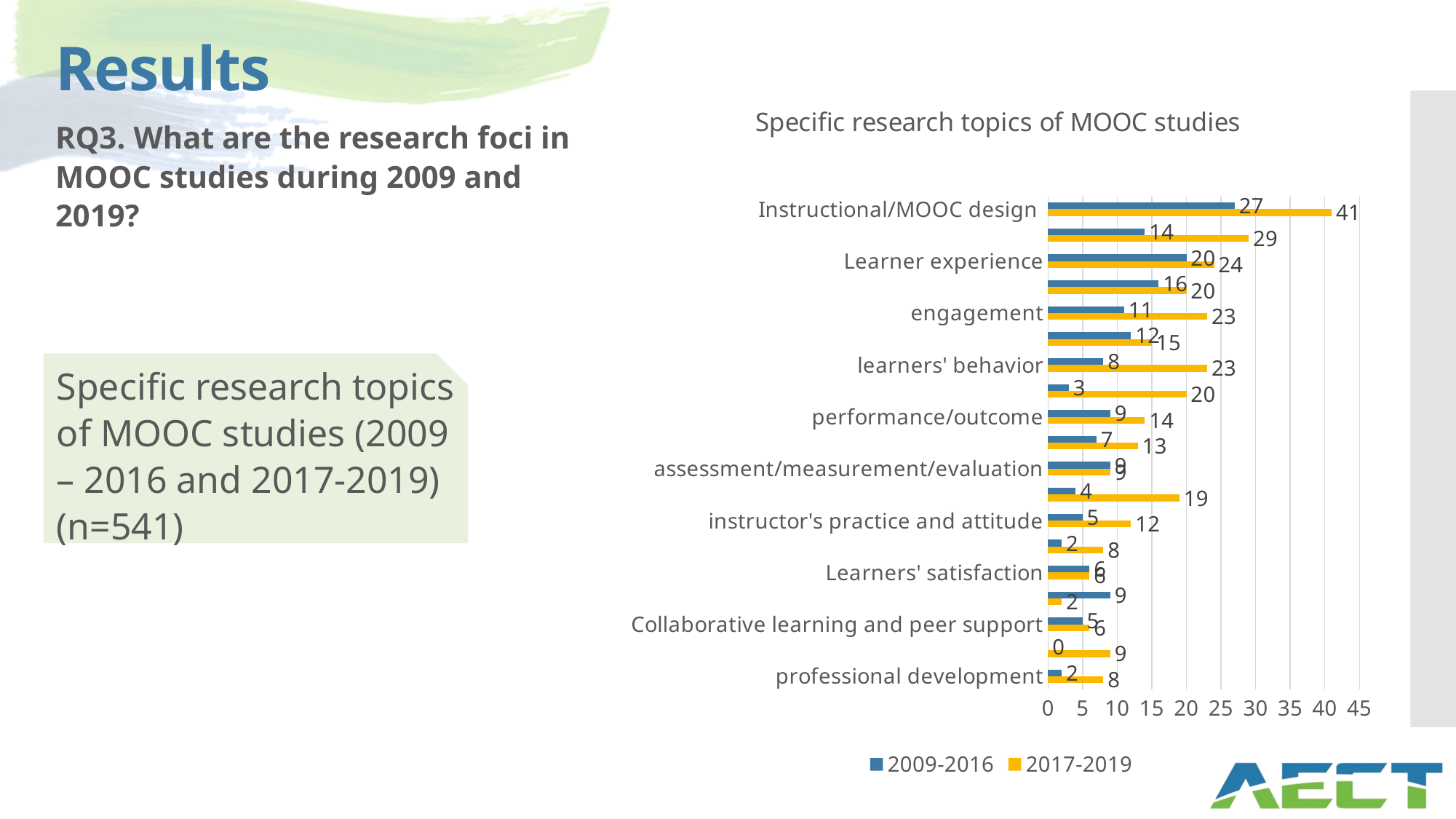
What is the 2017-2019 value for learners' behavior? 23 How many series does the legend list? 2 Which category has the highest 2017-2019 value? Instructional/MOOC design What kind of chart is shown on the slide? bar chart What is the difference between the 2017-2019 and 2009-2016 values for Instructional/MOOC design? 14 What is the difference between the 2017-2019 and 2009-2016 values for learners' behavior? 15 What is the 2017-2019 value for Instructional/MOOC design? 41 Which is larger: the 2009-2016 value for engagement or the 2009-2016 value for performance/outcome? engagement Which category has the highest 2009-2016 value? Instructional/MOOC design What is the 2009-2016 value for Learner experience? 20 What is the title of the chart? Specific research topics of MOOC studies What is the 2009-2016 value for professional development? 2